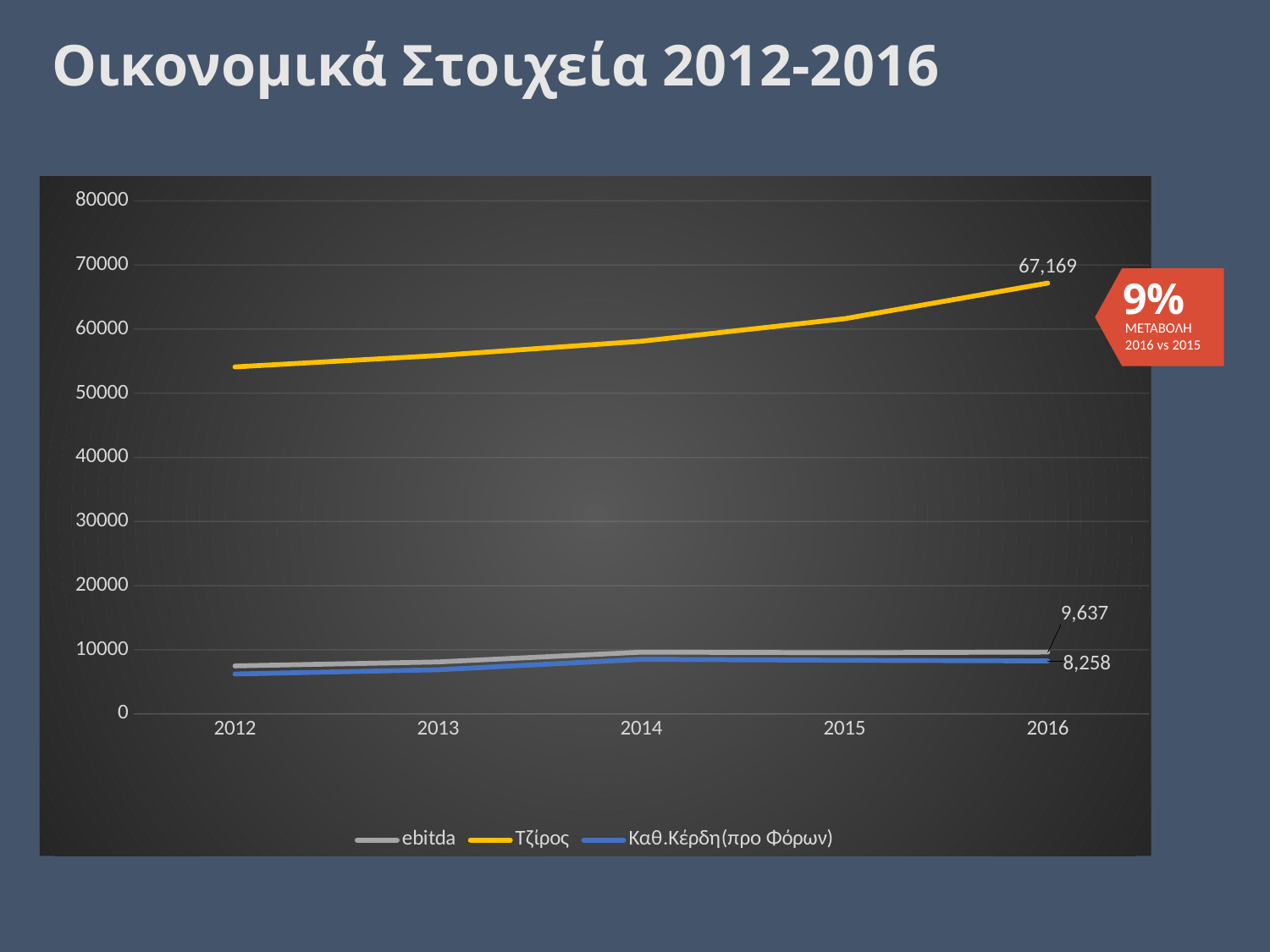
Is the value for Τζίρος in 2012 greater or less than 50000? greater What is the value of Καθ.Κέρδη(προ Φόρων) in 2016? 8,258 What is the value of ebitda in 2016? 9,637 In 2016, which is larger: ebitda or Καθ.Κέρδη(προ Φόρων)? ebitda What is the difference between ebitda and Καθ.Κέρδη(προ Φόρων) in 2016? 1,379 How many series does the legend list? 3 Does Τζίρος rise or fall from 2012 to 2016? rise What is the value of Τζίρος in 2016? 67,169 What is the difference between Τζίρος and ebitda in 2016? 57,532 How many years are shown on the x axis? 5 Is the value for Τζίρος in 2012 greater or less than 60000? less What kind of chart is shown on the slide? line chart